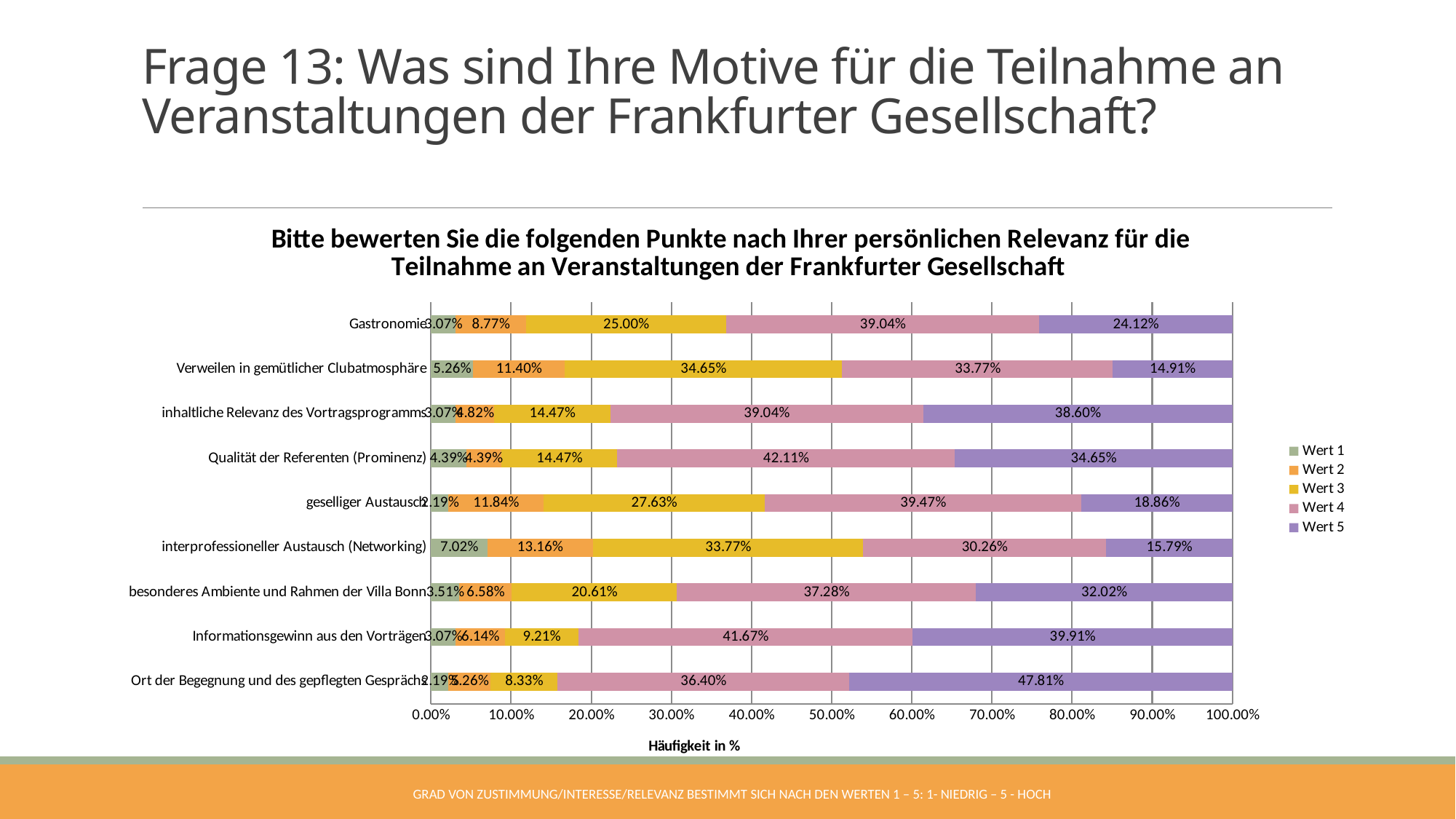
What is the difference between the Wert 4 value for "Gastronomie" and the Wert 5 value for "Gastronomie"? 14.92% Which category has the highest Wert 5 value? Ort der Begegnung und des gepflegten Gesprächs Which category has the lowest Wert 5 value? Verweilen in gemütlicher Clubatmosphäre What is the Wert 5 value for "Ort der Begegnung und des gepflegten Gesprächs"? 47.81% How many series does the legend list? 5 How many categories are shown on the y axis of the chart? 9 What is the Wert 4 value for "Qualität der Referenten (Prominenz)"? 42.11% What kind of chart is shown on the slide? Stacked bar chart What is the Wert 2 value for "interprofessioneller Austausch (Networking)"? 13.16% Which is larger: the Wert 3 value for "geselliger Austausch" or the Wert 3 value for "Gastronomie"? geselliger Austausch What is the Wert 3 value for "Verweilen in gemütlicher Clubatmosphäre"? 34.65% What is the title of the x axis of the chart? Häufigkeit in %